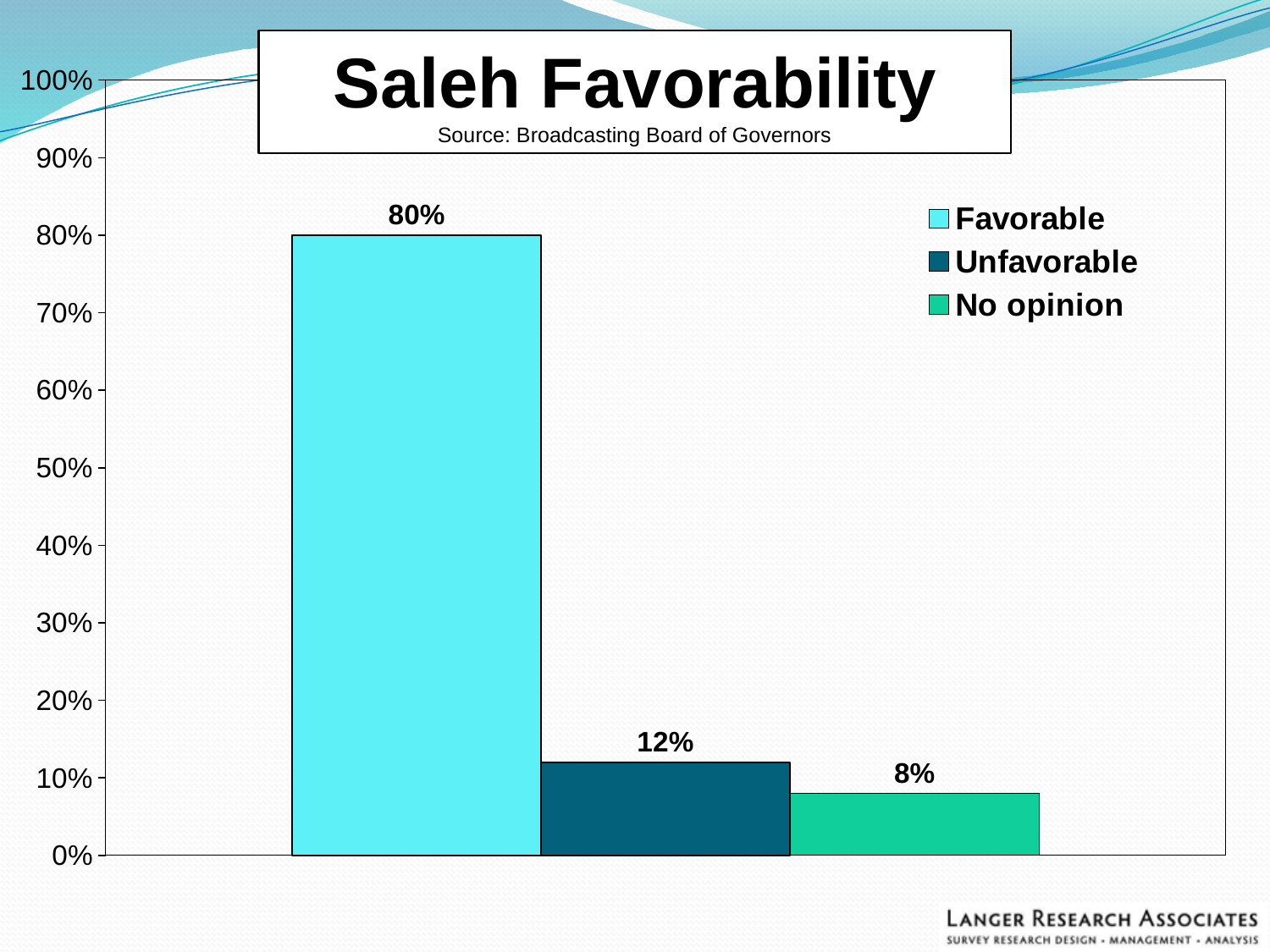
What is the value for No opinion? 8% Is the value for Favorable greater or less than 70%? greater Which response has the highest value? Favorable Which response has the lowest value? No opinion Which is larger, Unfavorable or No opinion? Unfavorable What is the difference between the Unfavorable and No opinion values? 4% How many series does the legend list? 3 What is the source cited under the chart title? Broadcasting Board of Governors What is the difference between the Favorable and Unfavorable values? 68% What kind of chart is shown on the slide? Bar chart What percentage of respondents view Saleh favorably? 80% What is the value for Unfavorable? 12%